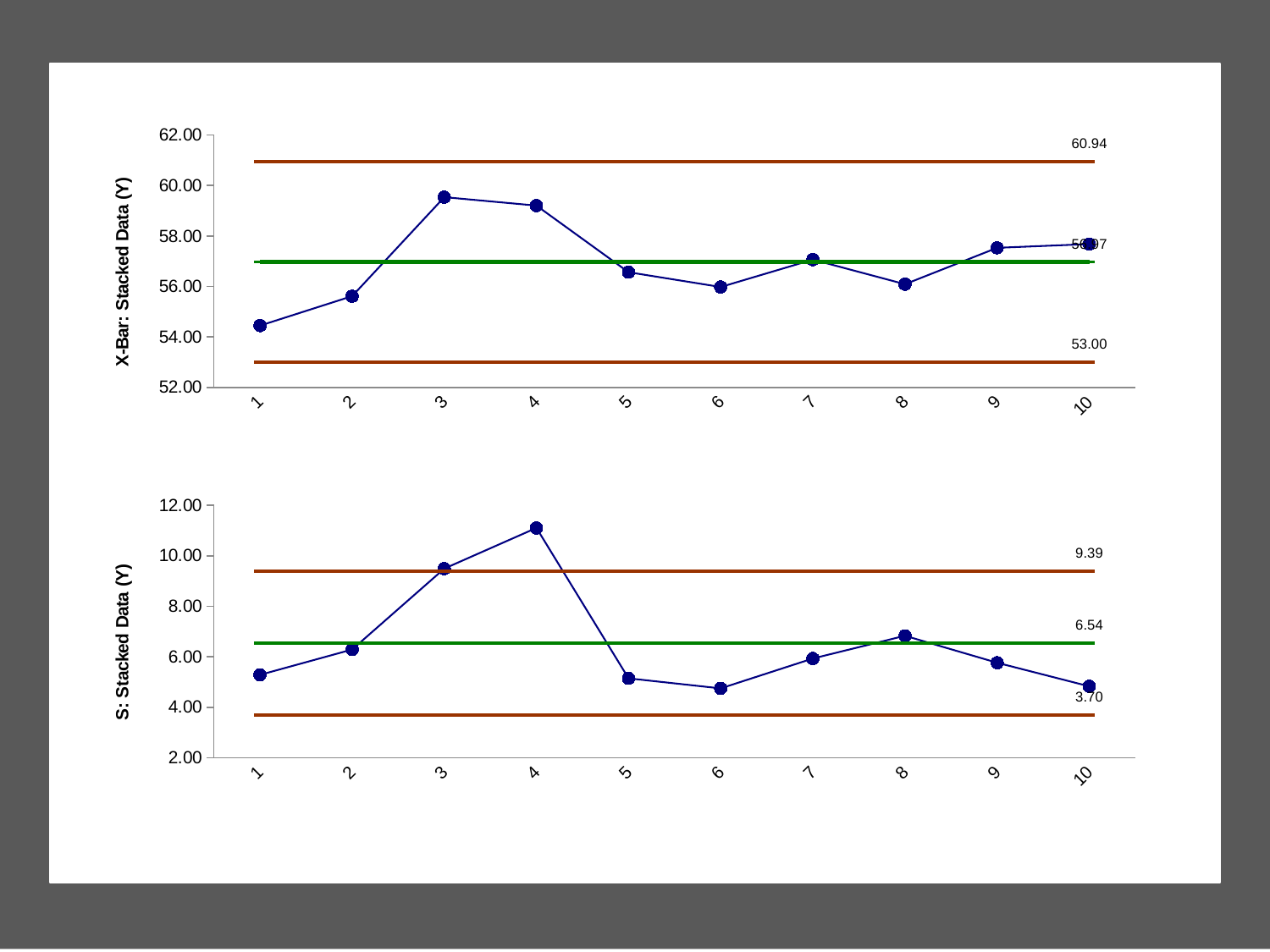
On the top chart (X-Bar: Stacked Data (Y)), what is the difference between the upper and lower control limit values? 7.94 On the top chart (X-Bar: Stacked Data (Y)), is the value for subgroup 3 greater or less than 58.00? greater On the bottom chart (S: Stacked Data (Y)), what value is labelled on the upper control limit line? 9.39 On the top chart (X-Bar: Stacked Data (Y)), which subgroup has the lowest plotted value? 1 What kind of chart is the bottom chart (S: Stacked Data (Y))? line chart On the top chart (X-Bar: Stacked Data (Y)), what value is labelled on the lower control limit line? 53.00 On the bottom chart (S: Stacked Data (Y)), what value is labelled on the green centre line? 6.54 On the bottom chart (S: Stacked Data (Y)), which subgroup has the highest plotted value? 4 On the bottom chart (S: Stacked Data (Y)), is the value for subgroup 3 larger or smaller than the value for subgroup 5? larger On the bottom chart (S: Stacked Data (Y)), what value is labelled on the lower control limit line? 3.70 On the top chart (X-Bar: Stacked Data (Y)), what value is labelled on the upper control limit line? 60.94 How many data points are plotted on the top chart (X-Bar: Stacked Data (Y))? 10